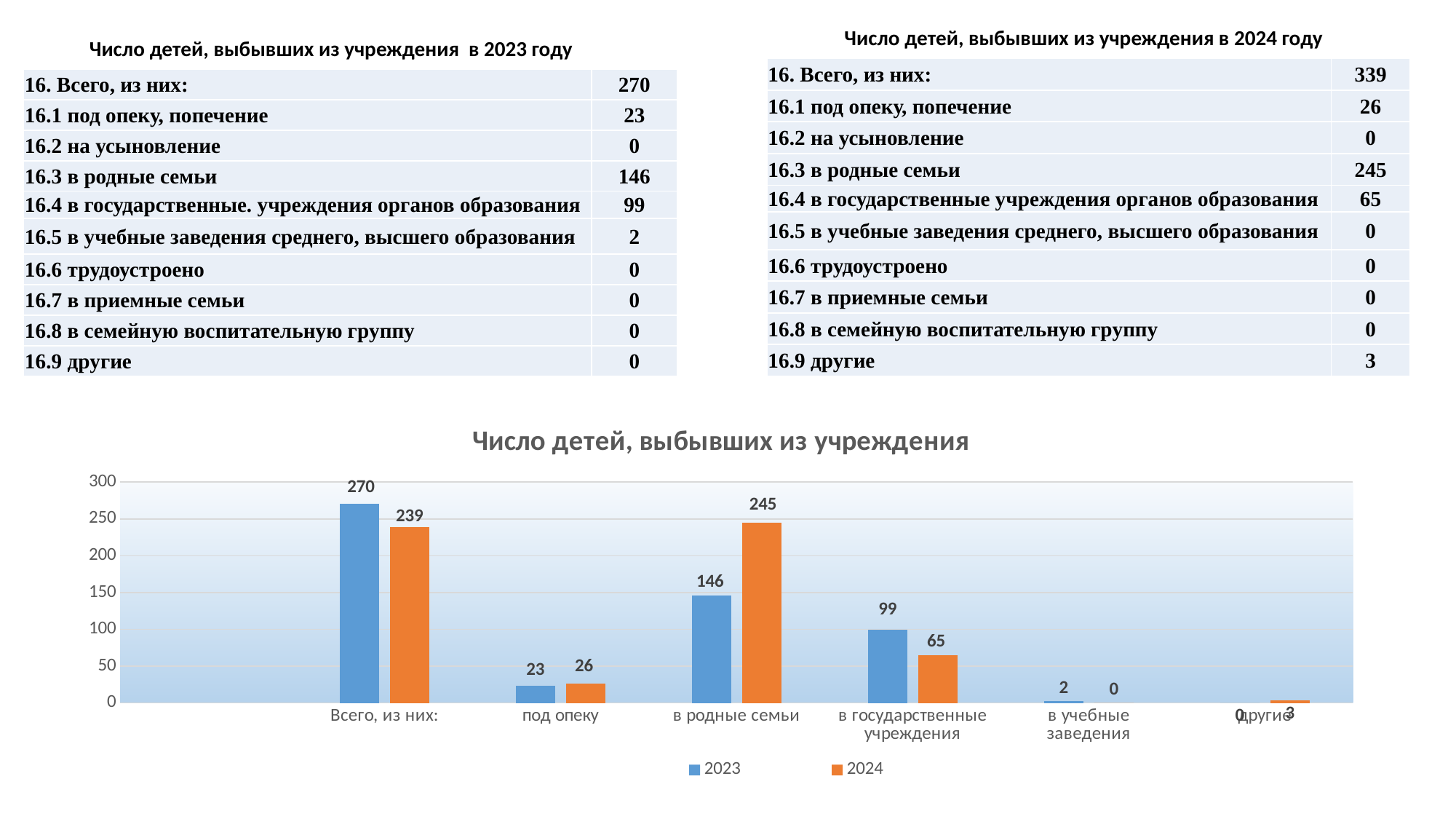
What is the 2023 value for 'в родные семьи' in the chart? 146 How many categories are shown on the x axis of the chart? 6 What is the 2023 value for 'под опеку' in the chart? 23 What type of chart is shown on the slide? bar chart What is the difference between the 2023 and 2024 values for 'в государственные учреждения'? 34 What is the 2024 value for 'в родные семьи' in the chart? 245 Which category has the highest 2024 value in the chart? в родные семьи What is the 2024 value for 'в государственные учреждения' in the chart? 65 What is the title of the chart? Число детей, выбывших из учреждения Which is larger for 'под опеку': the 2023 value or the 2024 value? 2024 How many series does the chart legend list? 2 What is the difference between the 2024 and 2023 values for 'в родные семьи'? 99